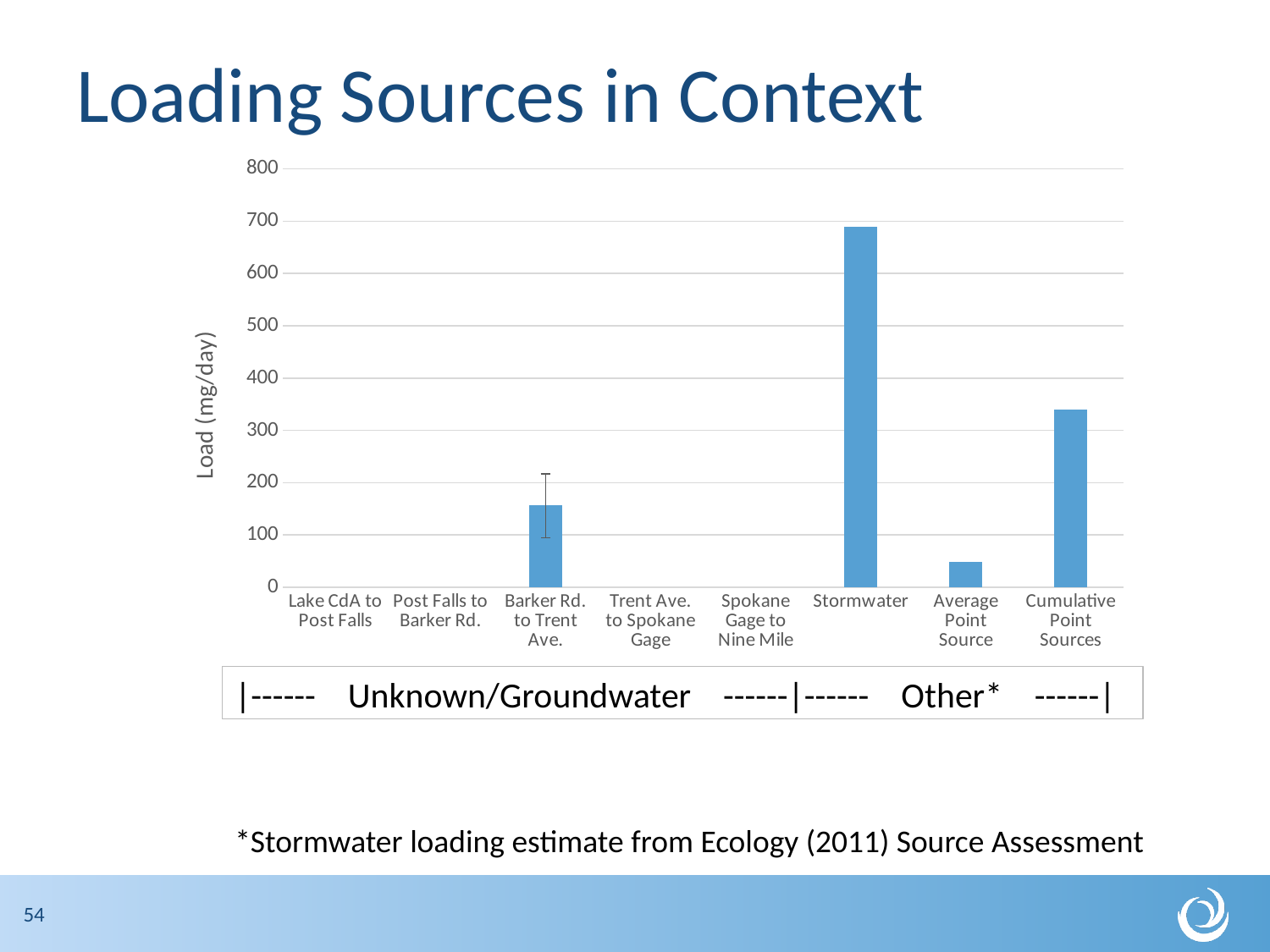
How many categories are shown on the x axis of the chart? 8 Is the value for Stormwater greater or less than 600? greater Which is larger, the value for Barker Rd. to Trent Ave. or the value for Average Point Source? Barker Rd. to Trent Ave. What is the title of the slide containing the chart? Loading Sources in Context What is the label on the y axis of the chart? Load (mg/day) Among the categories with a visible bar, which has the lowest value? Average Point Source Is the value for Average Point Source greater or less than 100? less Is the value for Barker Rd. to Trent Ave. greater or less than 200? less What kind of chart is shown on the slide? bar chart Which category has the highest load in the chart? Stormwater Which is larger, the value for Stormwater or the value for Cumulative Point Sources? Stormwater